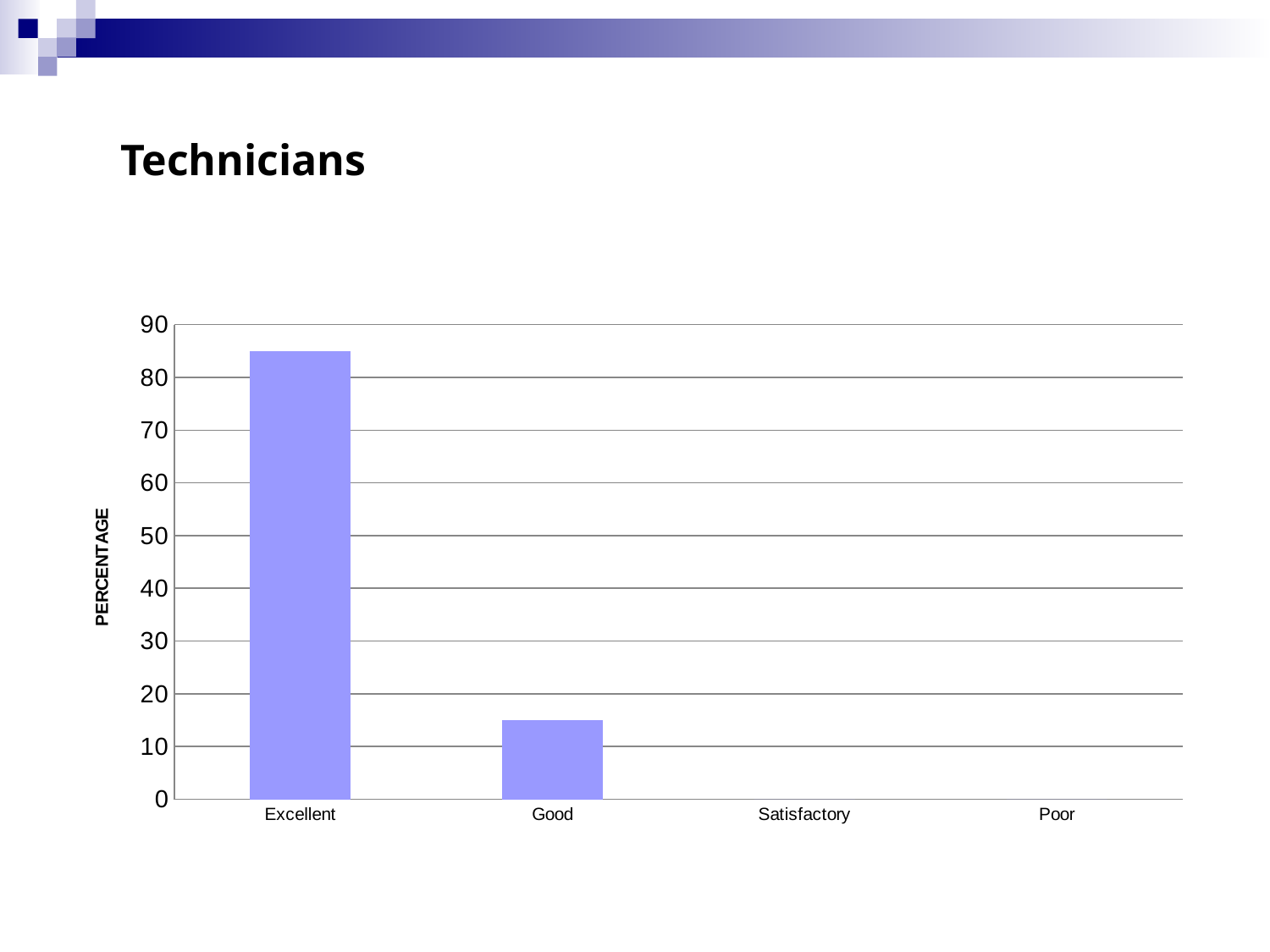
Do the values rise or fall moving from Excellent to Poor along the x axis? fall What is the title of the slide containing the chart? Technicians Is the value for Good greater or less than 10? greater How many categories are shown on the x axis of the chart? 4 What kind of chart is shown on the slide? bar chart Which is larger, the value for Excellent or the value for Good? Excellent Which category has the highest value in the chart? Excellent Is the value for Good greater or less than 20? less Is the value for Excellent greater or less than 90? less What is the label on the vertical axis of the chart? PERCENTAGE